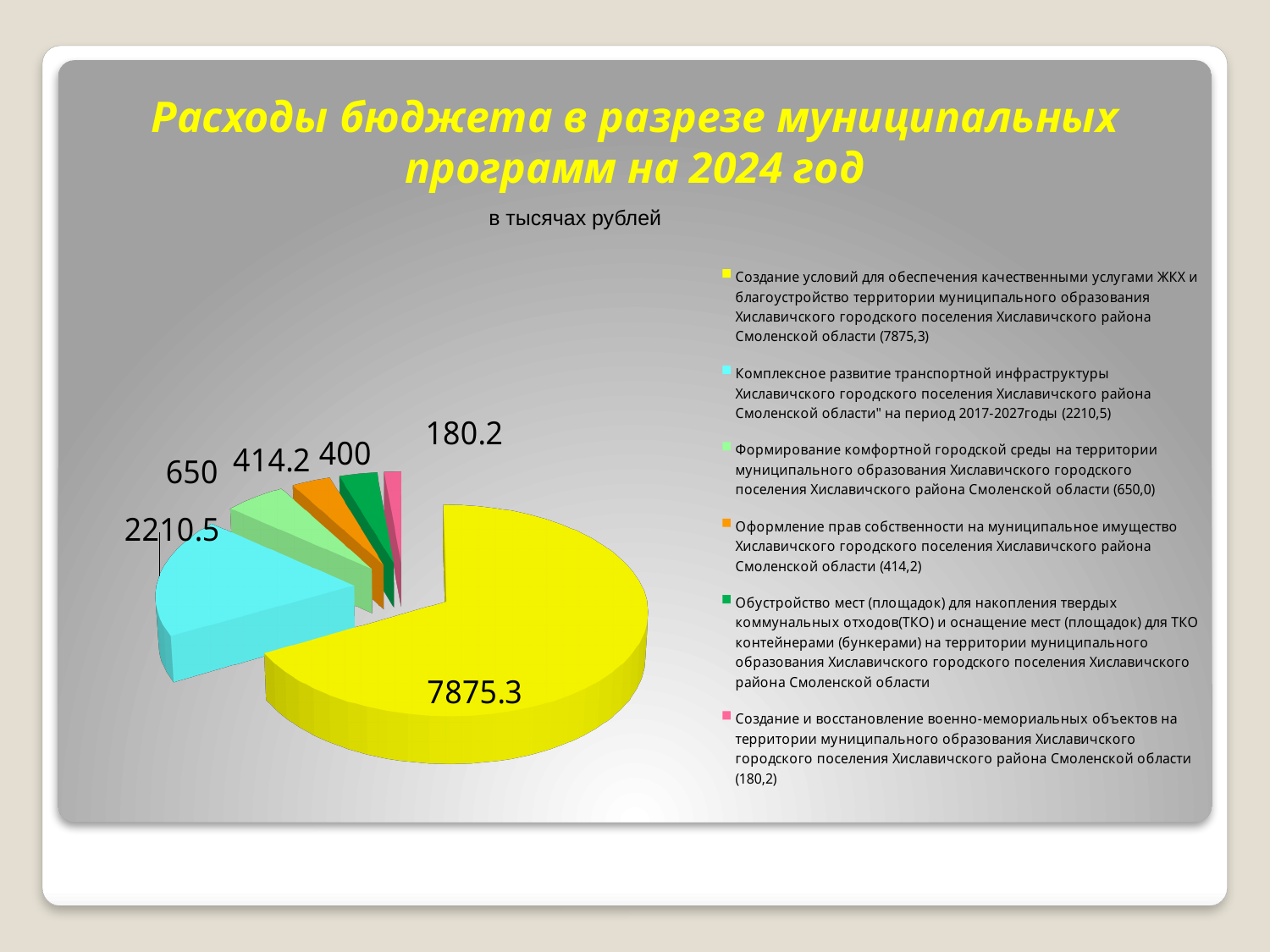
Which is larger: the slice labelled 650 or the slice labelled 414.2? 650 What value is labelled on the dark green slice (Обустройство мест для накопления ТКО)? 400 In what units are the values in the chart expressed, according to the subtitle? в тысячах рублей What is the value of the largest slice in the pie chart? 7875.3 What value is labelled on the light green slice (Формирование комфортной городской среды)? 650 How many slices does the pie chart have? 6 What is the difference between the largest slice (7875.3) and the second largest slice (2210.5)? 5664.8 What value is labelled on the cyan slice (Комплексное развитие транспортной инфраструктуры)? 2210.5 How many entries does the legend list? 6 What is the value of the smallest slice in the pie chart? 180.2 What value is labelled on the orange slice (Оформление прав собственности на муниципальное имущество)? 414.2 What type of chart is shown on the slide? Pie chart